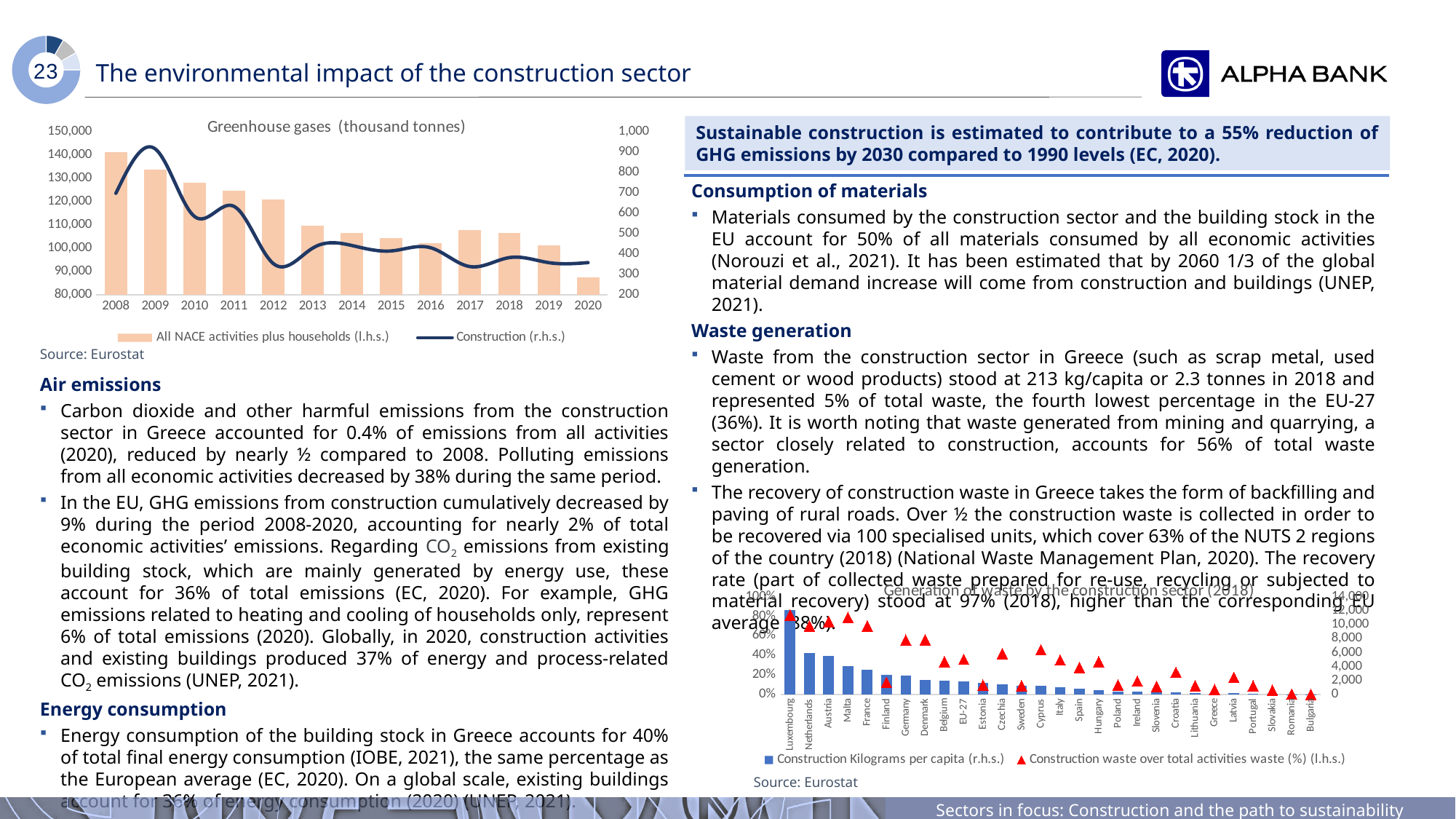
In the 'Greenhouse gases (thousand tonnes)' chart, is the 2020 value for All NACE activities plus households greater or less than 90,000? less In the 'Generation of waste by the construction sector (2018)' chart, which country has the highest bar for Construction Kilograms per capita? Luxembourg In the 'Greenhouse gases (thousand tonnes)' chart, in which year does the Construction line reach its peak? 2009 What kind of chart is the 'Greenhouse gases (thousand tonnes)' chart? A bar chart combined with a line chart In the 'Greenhouse gases (thousand tonnes)' chart, do the bars for All NACE activities plus households generally rise or fall from 2008 to 2020? fall In the 'Greenhouse gases (thousand tonnes)' chart, which series is plotted on the right-hand axis? Construction (r.h.s.) How many series does the legend of the 'Greenhouse gases (thousand tonnes)' chart list? 2 In the 'Greenhouse gases (thousand tonnes)' chart, which year has the lowest bar for All NACE activities plus households? 2020 In the 'Greenhouse gases (thousand tonnes)' chart, which year has the highest bar for All NACE activities plus households? 2008 How many years are shown on the x axis of the 'Greenhouse gases (thousand tonnes)' chart? 13 In the 'Generation of waste by the construction sector (2018)' chart, is the Construction Kilograms per capita value for Luxembourg greater or less than 10,000? greater How many series does the legend of the 'Generation of waste by the construction sector (2018)' chart list? 2